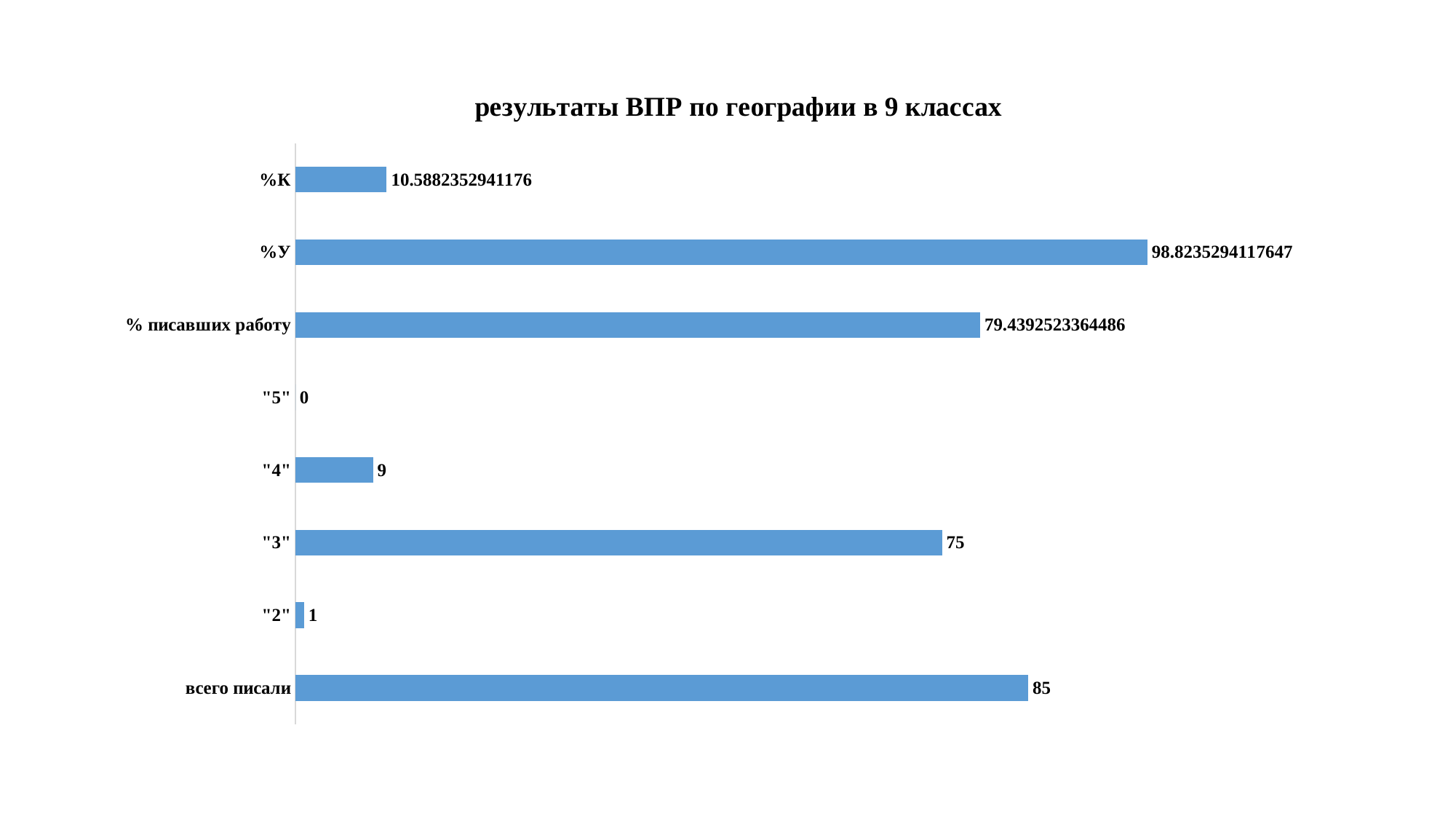
Which category has the lowest value? "5" How many categories are shown in the chart? 8 What is the value for "3"? 75 What is the value for "% писавших работу"? 79.4392523364486 What is the difference between the values for "всего писали" and "3"? 10 What is the title of the chart? результаты ВПР по географии в 9 классах What is the value for "%У"? 98.8235294117647 What is the value for "%К"? 10.5882352941176 Which is larger, the value for "4" or the value for "2"? "4" What is the value for "всего писали"? 85 What kind of chart is shown on the slide? Bar chart Which category has the highest value? %У